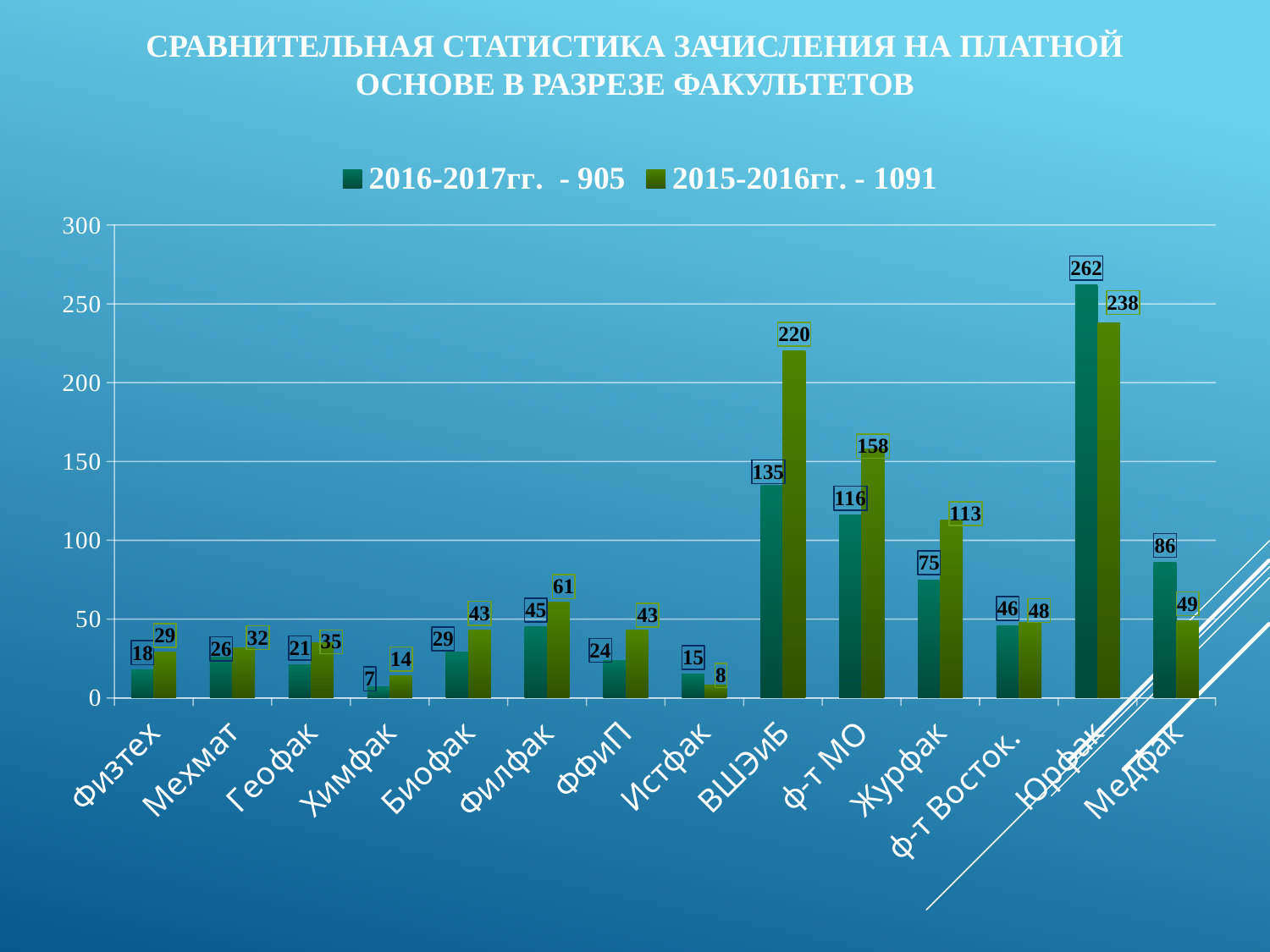
How many faculties (categories) are shown on the x axis? 14 Which is larger for Медфак: the 2016-2017гг. value or the 2015-2016гг. value? 2016-2017гг. Which faculty has the lowest value in the 2015-2016гг. series? Истфак What total is shown in the legend entry for the 2015-2016гг. series? 1091 What is the value for ВШЭиБ in the 2015-2016гг. series? 220 Which faculty has the highest value in the 2016-2017гг. series? Юрфак What is the value for Химфак in the 2016-2017гг. series? 7 What kind of chart is shown on the slide? bar chart What is the difference between the 2015-2016гг. and 2016-2017гг. values for ВШЭиБ? 85 Is the 2015-2016гг. value for ф-т МО greater or less than 150? greater What is the value for Юрфак in the 2016-2017гг. series? 262 How many series does the legend list? 2